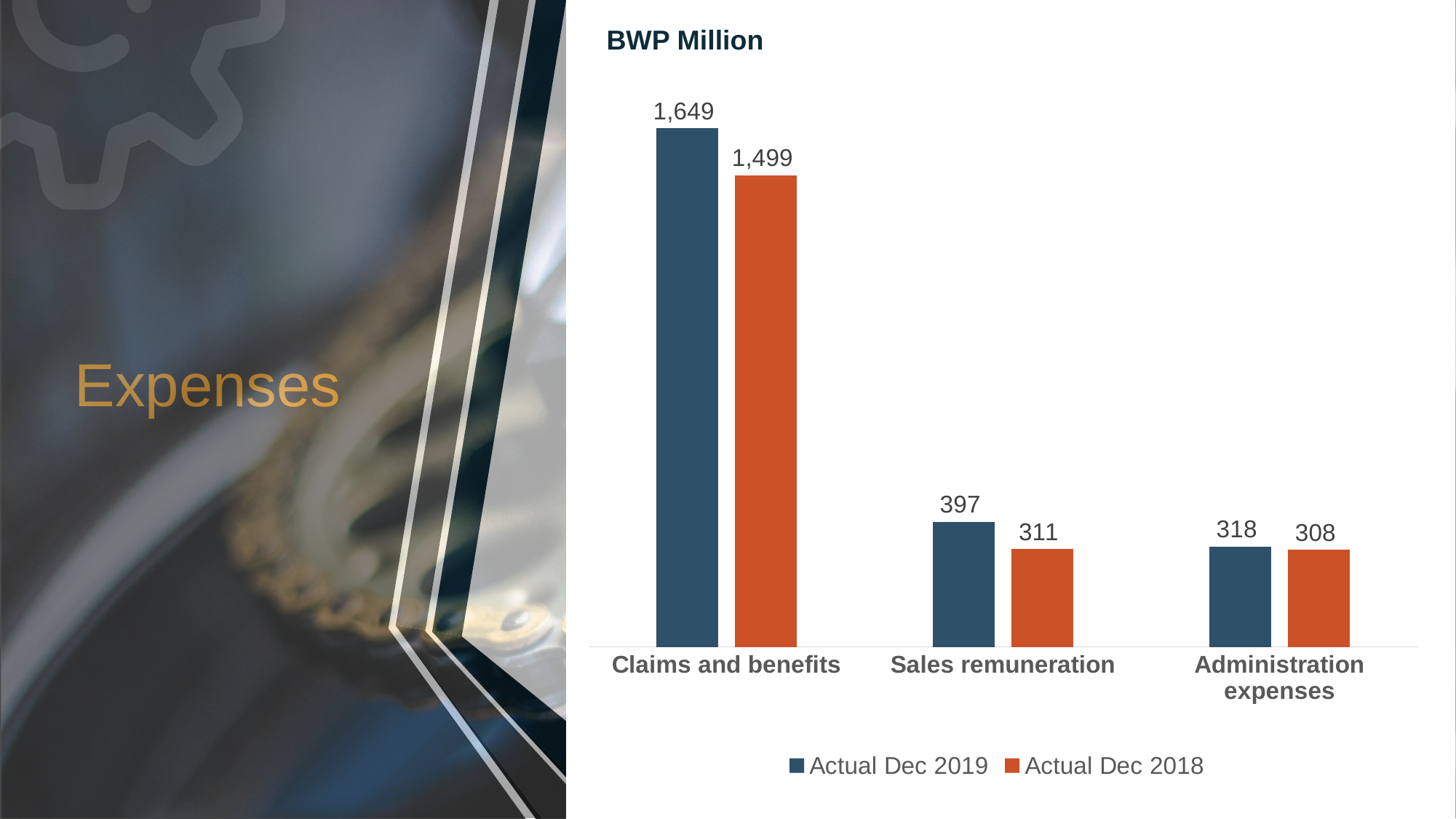
What kind of chart is shown on the slide? Bar chart What is the difference between the Actual Dec 2019 and Actual Dec 2018 values for Claims and benefits? 150 How many series does the legend list? 2 What is the value for Claims and benefits in the Actual Dec 2019 series? 1,649 Which category has the lowest value in the Actual Dec 2018 series? Administration expenses Which category has the highest value in the Actual Dec 2019 series? Claims and benefits How many categories are shown on the x axis? 3 What is the value for Sales remuneration in the Actual Dec 2018 series? 311 What is the value for Administration expenses in the Actual Dec 2019 series? 318 What unit is stated above the chart? BWP Million What is the difference between the Actual Dec 2019 and Actual Dec 2018 values for Sales remuneration? 86 Which is larger for Administration expenses: Actual Dec 2019 or Actual Dec 2018? Actual Dec 2019